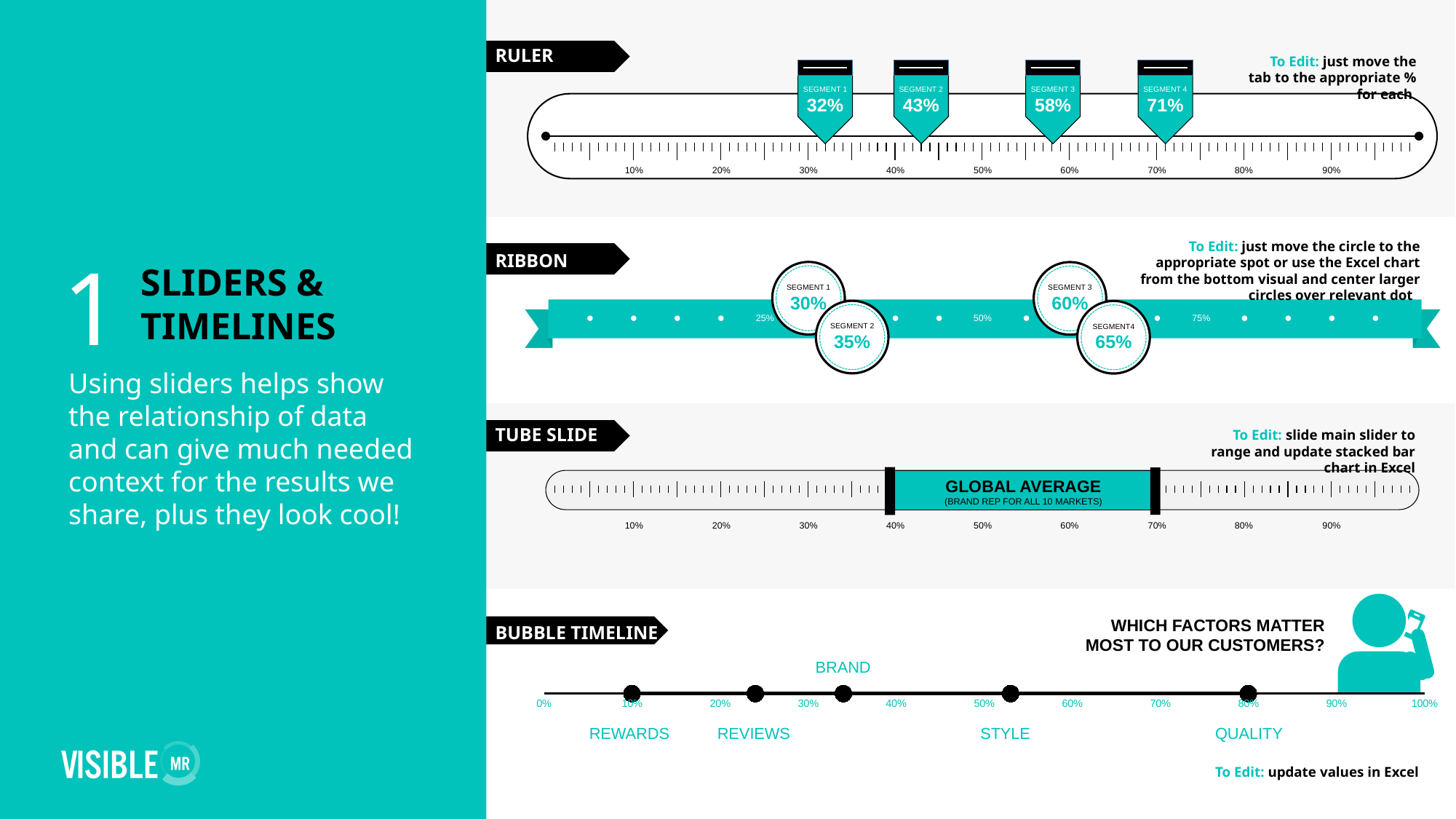
On the Ribbon chart, what is the value for Segment 2? 35% On the Ruler chart, what is the value for Segment 1? 32% On the Ribbon chart, what is the value for Segment 3? 60% On the Ruler chart, what is the value for Segment 4? 71% On the Ribbon chart, which segment has the lowest value? Segment 1 On the Ruler chart, what is the difference between Segment 3 and Segment 2? 15% On the Ribbon chart, what is the difference between Segment 4 and Segment 1? 35% On the Bubble Timeline chart, is the value for Quality greater or less than 70%? greater On the Bubble Timeline chart, which factor is placed furthest to the right on the axis? Quality On the Ruler chart, how many segment tabs are shown? 4 On the Ruler chart, which segment has the highest value? Segment 4 On the Bubble Timeline chart, is the value for Rewards greater or less than 20%? less